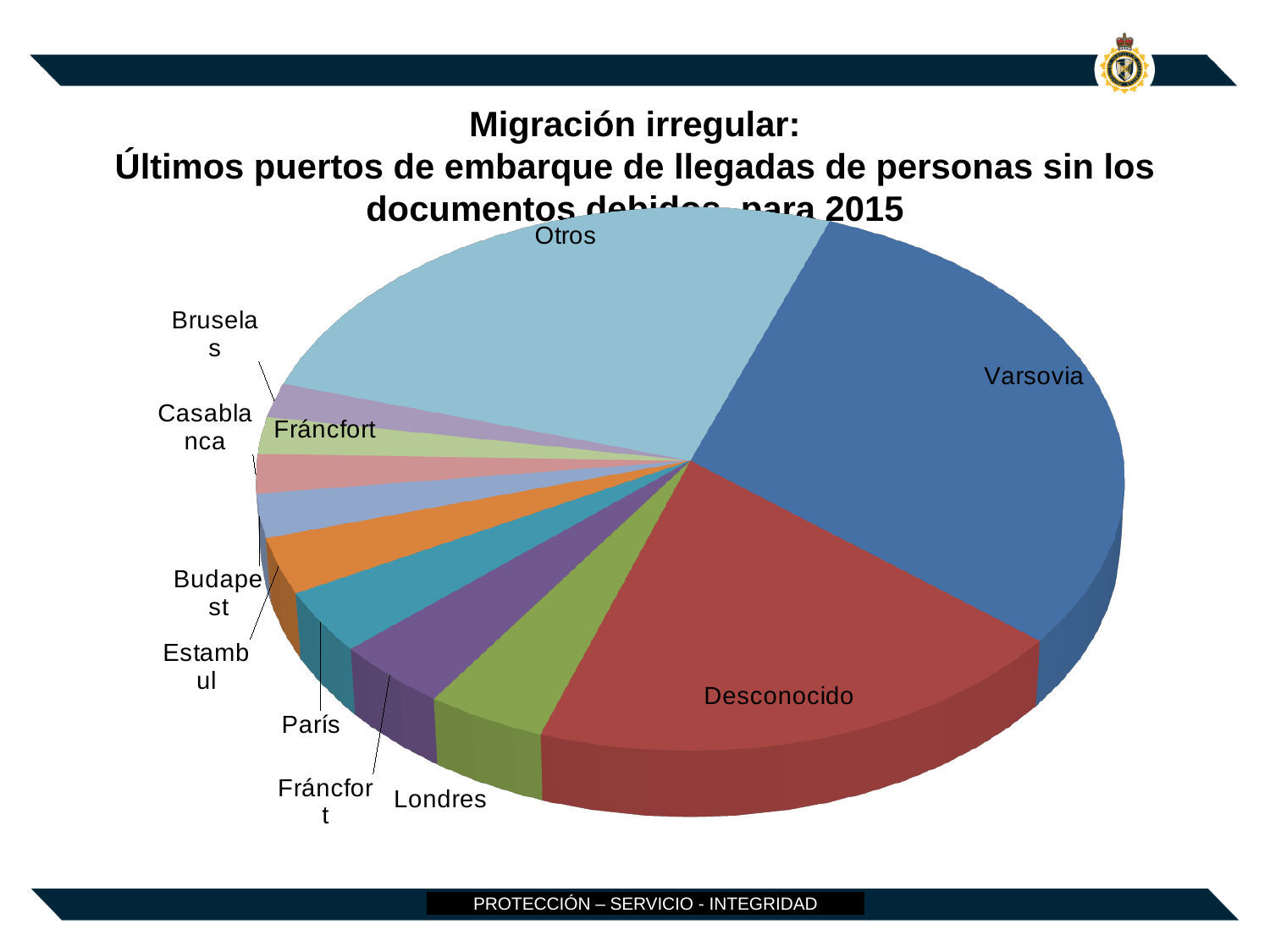
Which category has the largest slice of the pie? Varsovia Which slice is larger, Varsovia or Estambul? Varsovia What colour is the Desconocido slice? red Which slice is larger, Londres or Bruselas? Londres Which slice is larger, Varsovia or Desconocido? Varsovia What kind of chart is shown on the slide? pie chart What year does the chart title say the data is for? 2015